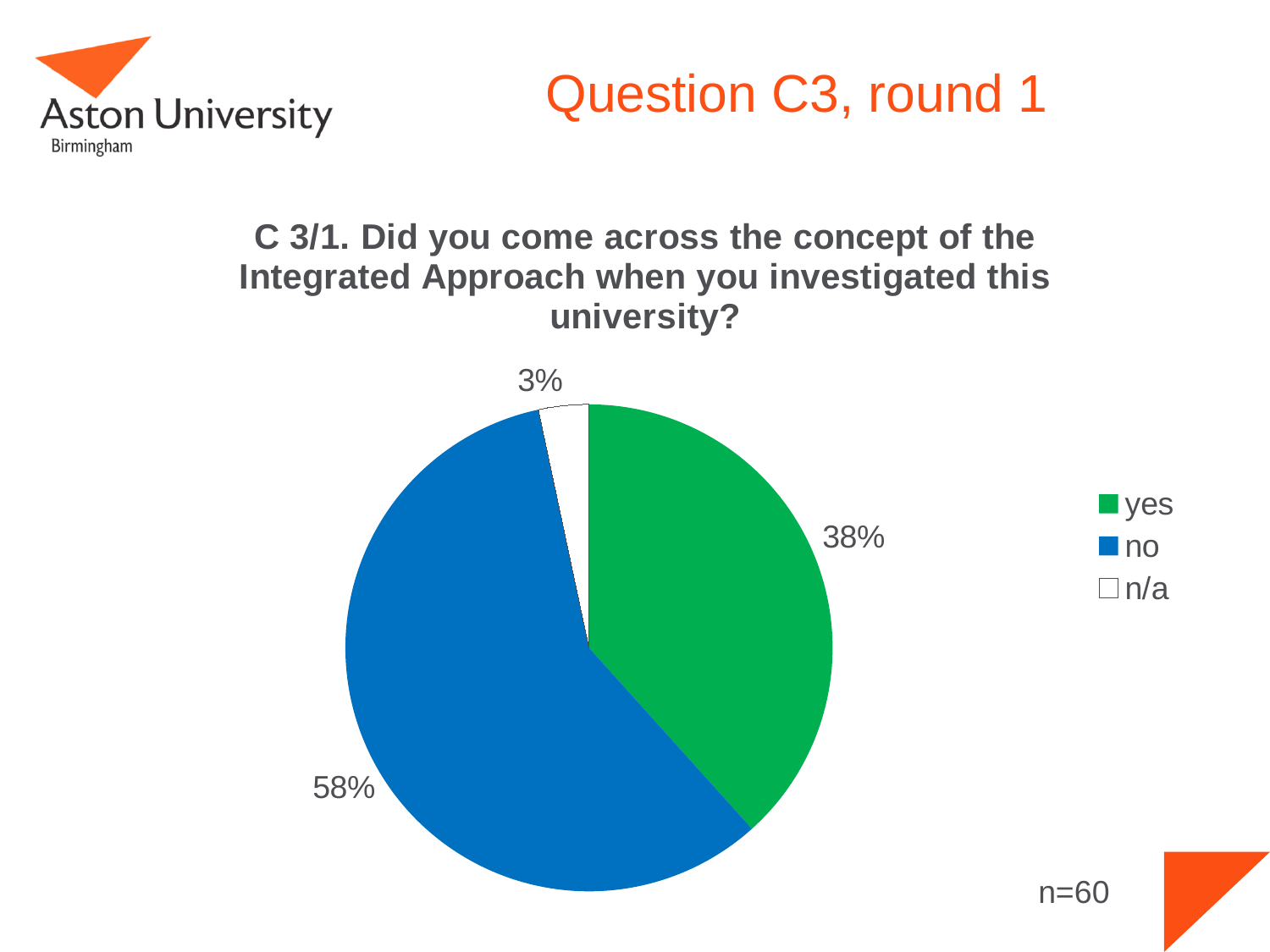
What percentage of respondents answered "no"? 58% What percentage of respondents answered "n/a"? 3% How many entries does the legend list? 3 Which is larger, the share for "yes" or the share for "no"? no How many slices does the pie chart have? 3 What percentage of respondents answered "yes"? 38% What kind of chart is shown on the slide? pie chart Which response has the largest share of the pie? no Which response has the smallest share of the pie? n/a What is the difference in percentage points between the "no" and "yes" shares? 20 What is the sample size (n) shown on the slide? n=60 What colour is the "no" slice? blue